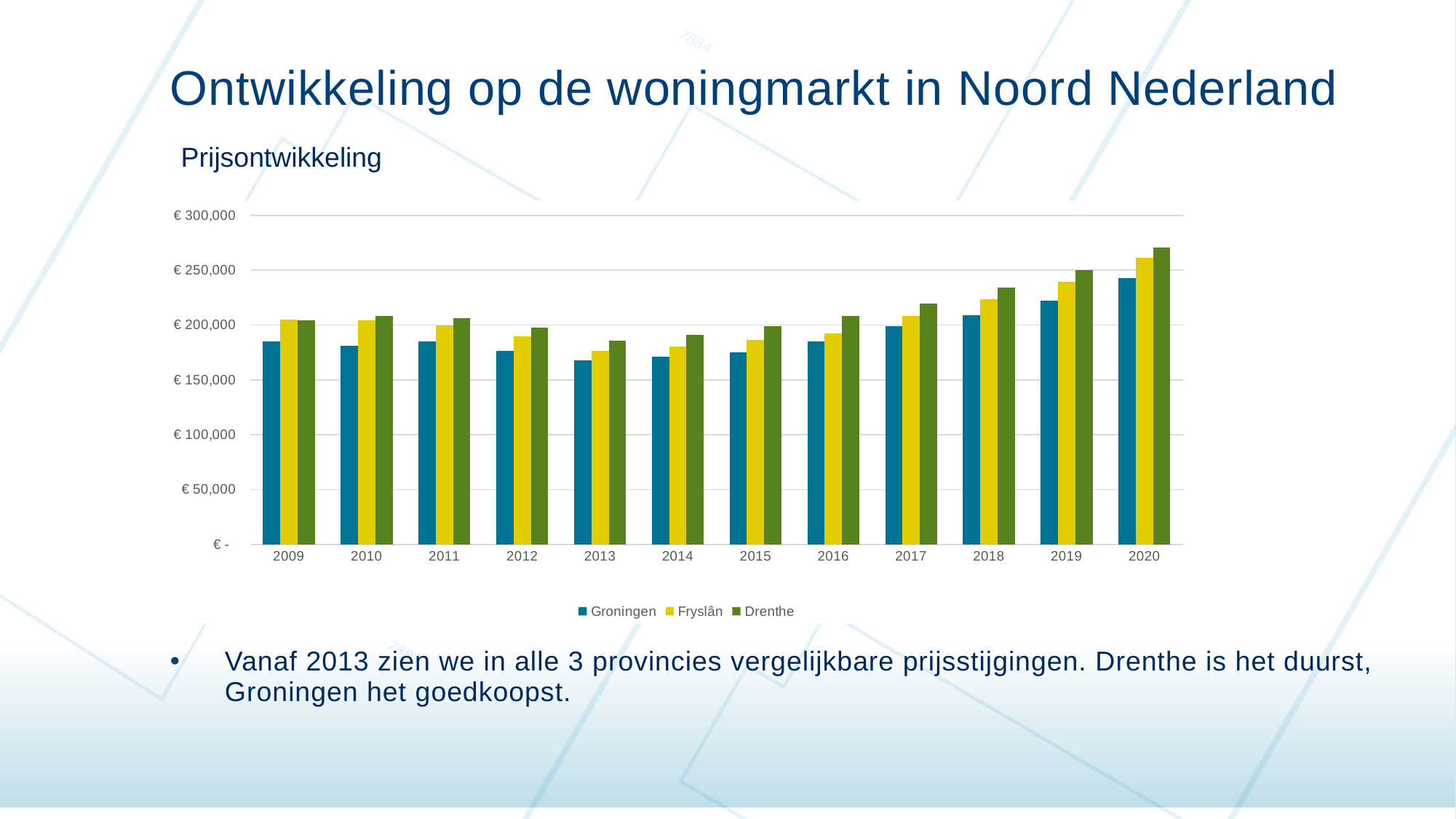
Which series has the highest value in 2020? Drenthe Which series has the lowest value in 2020? Groningen Which is larger: Fryslân in 2019 or Groningen in 2019? Fryslân in 2019 What kind of chart is shown on the slide? Bar chart In which year is the Drenthe value highest? 2020 What is the title of the chart? Prijsontwikkeling How many years are shown on the x axis? 12 Is the value for Groningen in 2013 greater or less than € 200,000? less Do the values for Drenthe rise or fall from 2013 to 2020? Rise How many series does the legend list? 3 Is the value for Groningen in 2020 greater or less than € 200,000? greater Is the value for Drenthe in 2020 greater or less than € 250,000? greater